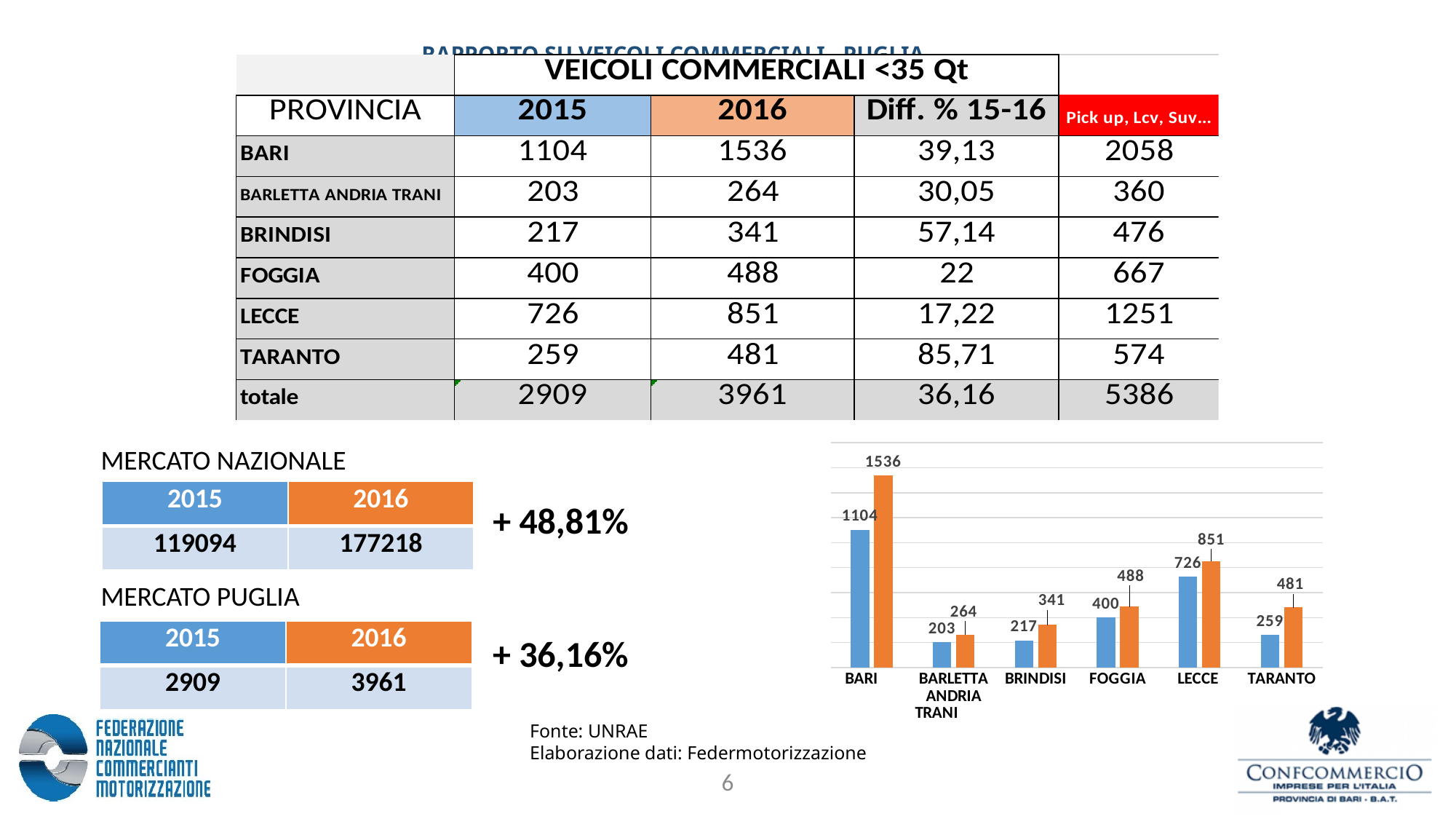
Which province has the highest orange (2016) bar in the bar chart? BARI In the bar chart, what is the difference between the 2016 and 2015 bars for BARI? 432 In the bar chart, what is the difference between the 2016 and 2015 bars for TARANTO? 222 How many bars are plotted for each province in the bar chart? 2 In the bar chart, what is the value of the blue (2015) bar for LECCE? 726 In the bar chart, what is the value of the blue (2015) bar for FOGGIA? 400 In the bar chart, which is larger: the 2015 bar for LECCE or the 2016 bar for FOGGIA? the 2015 bar for LECCE In the bar chart, what is the value of the orange (2016) bar for BRINDISI? 341 Which province has the lowest blue (2015) bar in the bar chart? BARLETTA ANDRIA TRANI What kind of chart is shown at the bottom right of the slide? bar chart How many provinces are shown on the x axis of the bar chart? 6 In the bar chart, what is the value of the orange (2016) bar for BARI? 1536